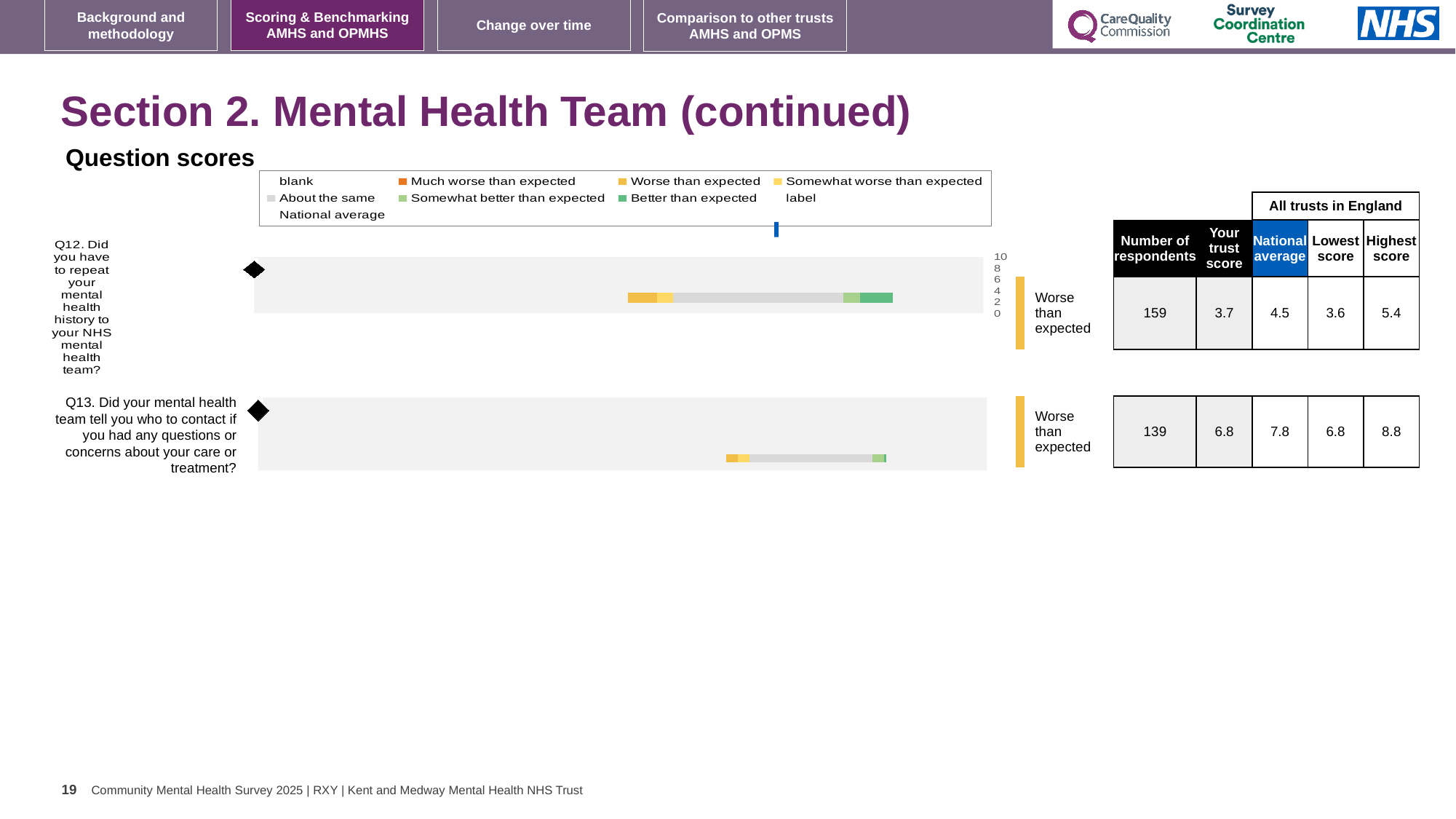
What rating label is shown beside the Q13 chart? Worse than expected For Q13, what is the difference between the national average and the trust's score? 1.0 For Q12, what is the difference between the highest score and the lowest score among all trusts in England? 1.8 In the table next to the Q13 chart, what is the trust's score? 6.8 In the table next to the Q12 chart, what is the national average? 4.5 In the table next to the Q13 chart, what is the highest score among all trusts in England? 8.8 In the table next to the Q12 chart, what is the trust's score? 3.7 What rating label is shown beside the Q12 chart? Worse than expected What kind of chart is used to show the question scores for Q12 and Q13? bar chart How many survey questions are charted on this slide? 2 For Q12, which is larger: the trust's score or the national average? national average In the table next to the Q12 chart, what is the number of respondents? 159